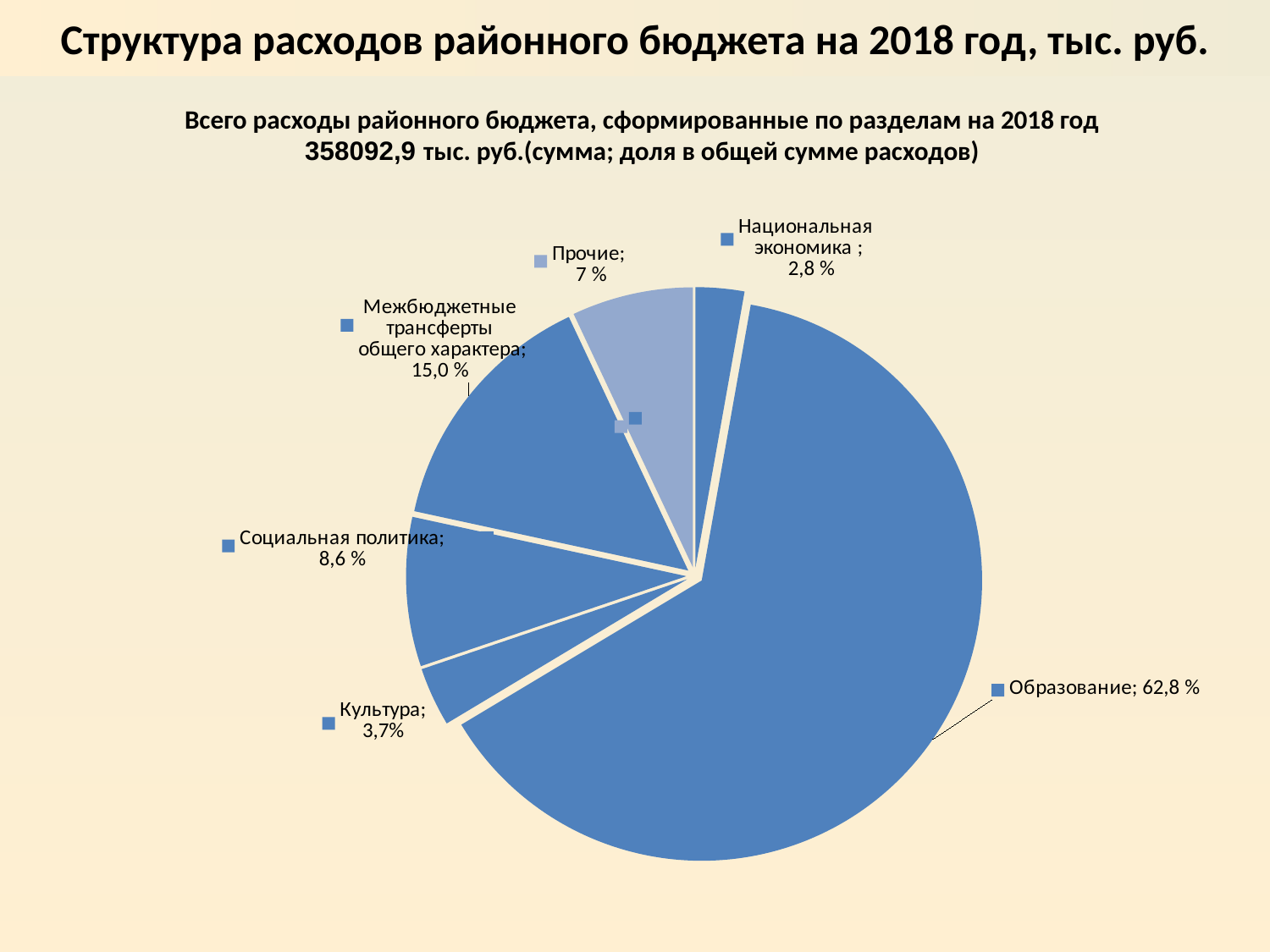
What share is shown for Национальная экономика? 2,8 % What share is shown for Межбюджетные трансферты общего характера? 15,0 % Which labelled category has the smallest share of the pie? Национальная экономика What kind of chart is shown on the slide? pie chart What share is shown for Культура? 3,7% What share of expenditures does Образование account for? 62,8 % What share is shown for Социальная политика? 8,6 % Which is larger, the share for Социальная политика or the share for Прочие? Социальная политика What share is shown for Прочие? 7 % Which category has the largest share of the pie? Образование What total amount of district budget expenditures for 2018 is stated above the chart? 358092,9 тыс. руб. By how many percentage points does the share for Образование exceed the share for Межбюджетные трансферты общего характера? 47,8